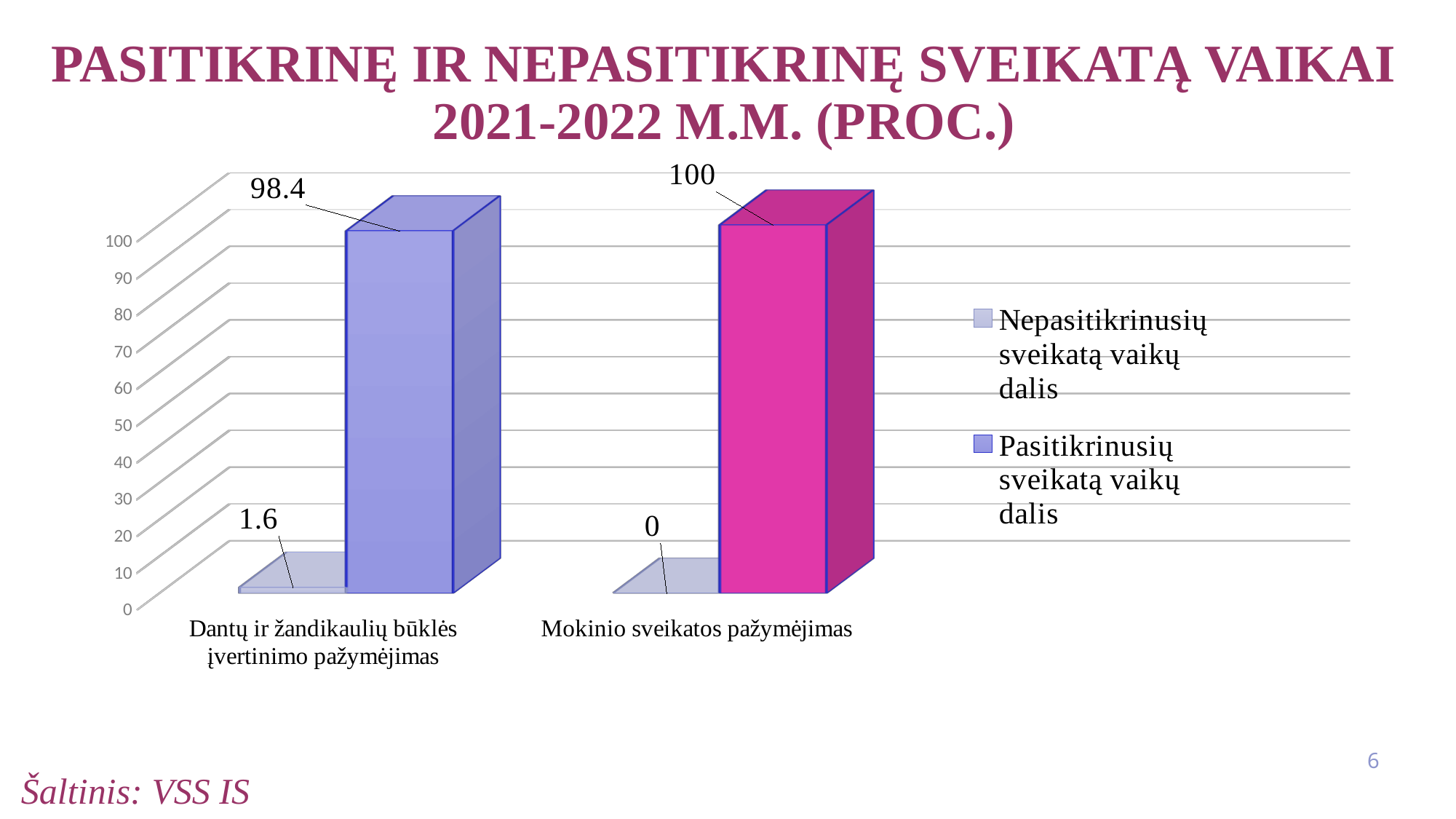
Is the Nepasitikrinusių sveikatą vaikų dalis value for Dantų ir žandikaulių būklės įvertinimo pažymėjimas larger or smaller than the Pasitikrinusių sveikatą vaikų dalis value for the same category? smaller What is the value of Nepasitikrinusių sveikatą vaikų dalis for Dantų ir žandikaulių būklės įvertinimo pažymėjimas? 1.6 What is the difference between the Pasitikrinusių sveikatą vaikų dalis values for Mokinio sveikatos pažymėjimas and Dantų ir žandikaulių būklės įvertinimo pažymėjimas? 1.6 Is the Pasitikrinusių sveikatą vaikų dalis value for Dantų ir žandikaulių būklės įvertinimo pažymėjimas greater or less than 90? greater How many categories are shown on the x axis of the chart? 2 How many series does the chart legend list? 2 Which category has the higher value for Pasitikrinusių sveikatą vaikų dalis? Mokinio sveikatos pažymėjimas What is the value of Pasitikrinusių sveikatą vaikų dalis for Mokinio sveikatos pažymėjimas? 100 What type of chart is shown on the slide? bar chart What is the value of Nepasitikrinusių sveikatą vaikų dalis for Mokinio sveikatos pažymėjimas? 0 What is the value of Pasitikrinusių sveikatą vaikų dalis for Dantų ir žandikaulių būklės įvertinimo pažymėjimas? 98.4 Which category has the lower value for Nepasitikrinusių sveikatą vaikų dalis? Mokinio sveikatos pažymėjimas